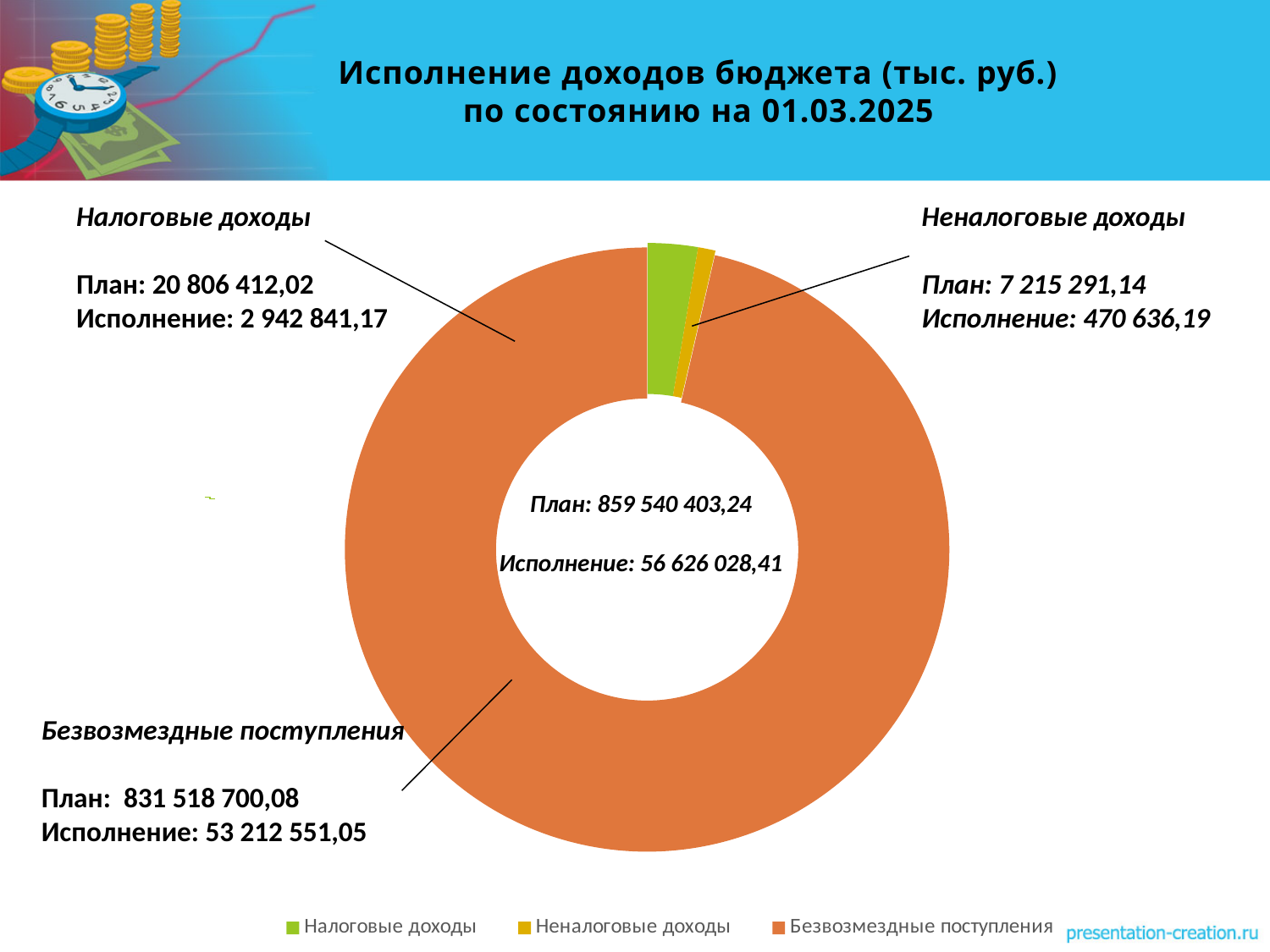
Which category has the smallest share of the doughnut chart? Неналоговые доходы What colour represents Безвозмездные поступления in the chart? Orange How many entries does the legend list? 3 What is the total plan (План) value shown in the centre of the chart? 859 540 403,24 What kind of chart is shown on the slide? Doughnut (pie) chart What is the total execution (Исполнение) value across all three categories, as shown in the centre of the chart? 56 626 028,41 What is the plan (План) value for Неналоговые доходы? 7 215 291,14 How many categories does the chart show? 3 Which is larger: the execution value for Налоговые доходы or for Неналоговые доходы? Налоговые доходы What is the execution (Исполнение) value for Налоговые доходы? 2 942 841,17 What is the execution (Исполнение) value for Безвозмездные поступления? 53 212 551,05 Which category has the largest share of the doughnut chart? Безвозмездные поступления